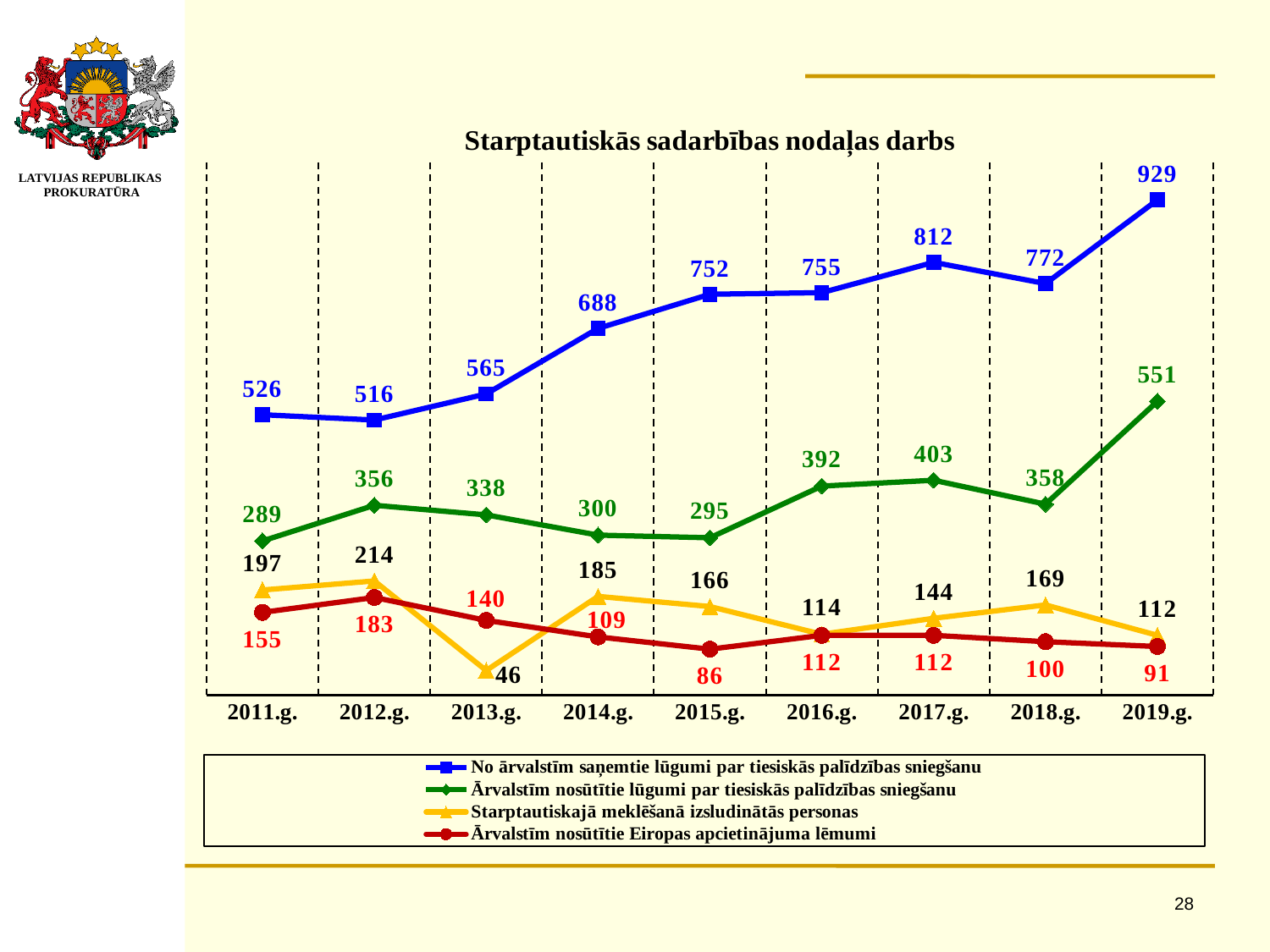
What is the difference between the 2019.g. and 2018.g. values for 'Ārvalstīm nosūtītie lūgumi par tiesiskās palīdzības sniegšanu'? 193 What is the value for 'Starptautiskajā meklēšanā izsludinātās personas' in 2013.g.? 46 Which is larger in 2014.g.: 'Starptautiskajā meklēšanā izsludinātās personas' or 'Ārvalstīm nosūtītie Eiropas apcietinājuma lēmumi'? Starptautiskajā meklēšanā izsludinātās personas What is the value for 'Ārvalstīm nosūtītie Eiropas apcietinājuma lēmumi' in 2015.g.? 86 What is the value for 'No ārvalstīm saņemtie lūgumi par tiesiskās palīdzības sniegšanu' in 2019.g.? 929 How many series does the legend list? 4 In which year is 'Starptautiskajā meklēšanā izsludinātās personas' lowest? 2013.g. In which year is 'No ārvalstīm saņemtie lūgumi par tiesiskās palīdzības sniegšanu' highest? 2019.g. What kind of chart is shown on the slide? Line chart What is the title of the chart? Starptautiskās sadarbības nodaļas darbs What is the value for 'Ārvalstīm nosūtītie lūgumi par tiesiskās palīdzības sniegšanu' in 2016.g.? 392 How many years are shown on the x axis? 9